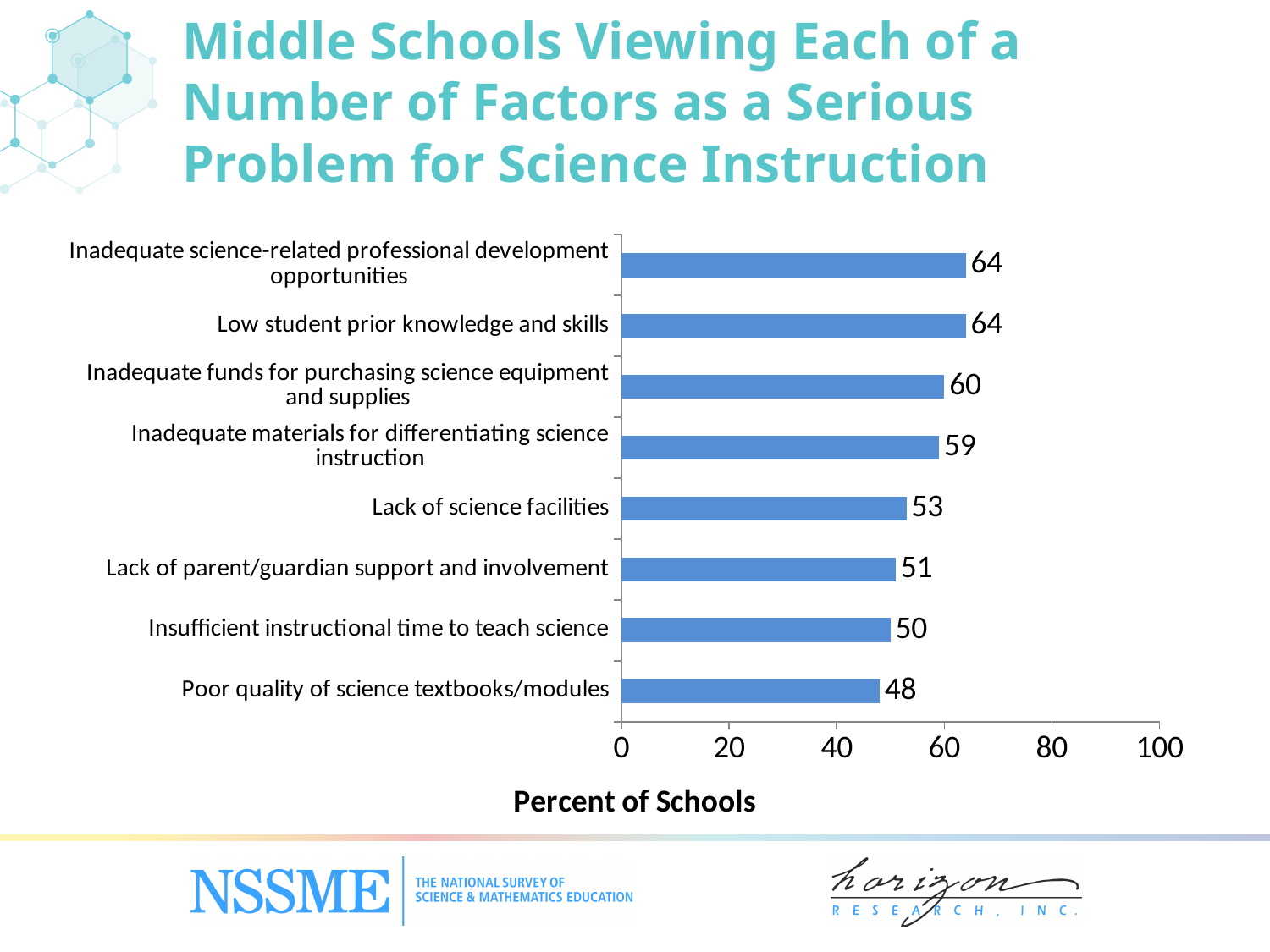
Which is larger: the value for inadequate materials for differentiating science instruction or the value for lack of science facilities? Inadequate materials for differentiating science instruction Which factor has the lowest value? Poor quality of science textbooks/modules What is the value for insufficient instructional time to teach science? 50 What kind of chart is shown on the slide? Bar chart What percent of schools view lack of science facilities as a serious problem? 53 What is the label of the horizontal axis? Percent of Schools How many factors are shown in the chart? 8 What is the difference between the values for low student prior knowledge and skills and lack of parent/guardian support and involvement? 13 What is the highest value shown on the horizontal axis? 100 What is the value for inadequate funds for purchasing science equipment and supplies? 60 Is the value for lack of parent/guardian support and involvement greater or less than 60? less What is the value for poor quality of science textbooks/modules? 48